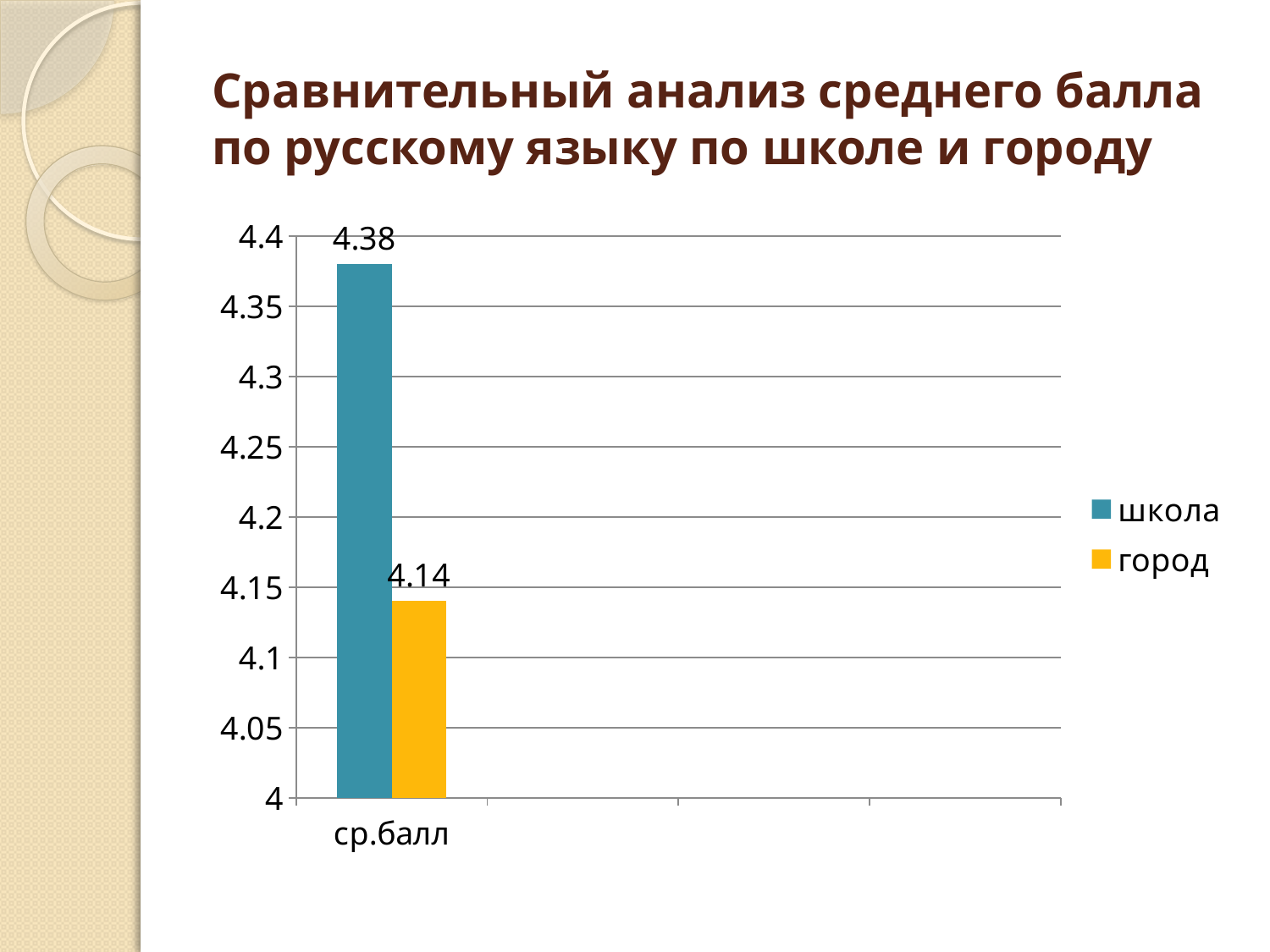
Which series has the lowest value on the chart? город Which series has the higher value, школа or город? школа How many series does the legend list? 2 What is the title of the slide? Сравнительный анализ среднего балла по русскому языку по школе и городу How many categories are shown on the x axis? 1 What is the value for город in the ср.балл category? 4.14 What is the difference between the школа value and the город value? 0.24 What kind of chart is shown on the slide? bar chart What colour is the bar for город? yellow Is the value for город greater or less than 4.2? less Is the value for школа greater or less than 4.3? greater What is the value for школа in the ср.балл category? 4.38